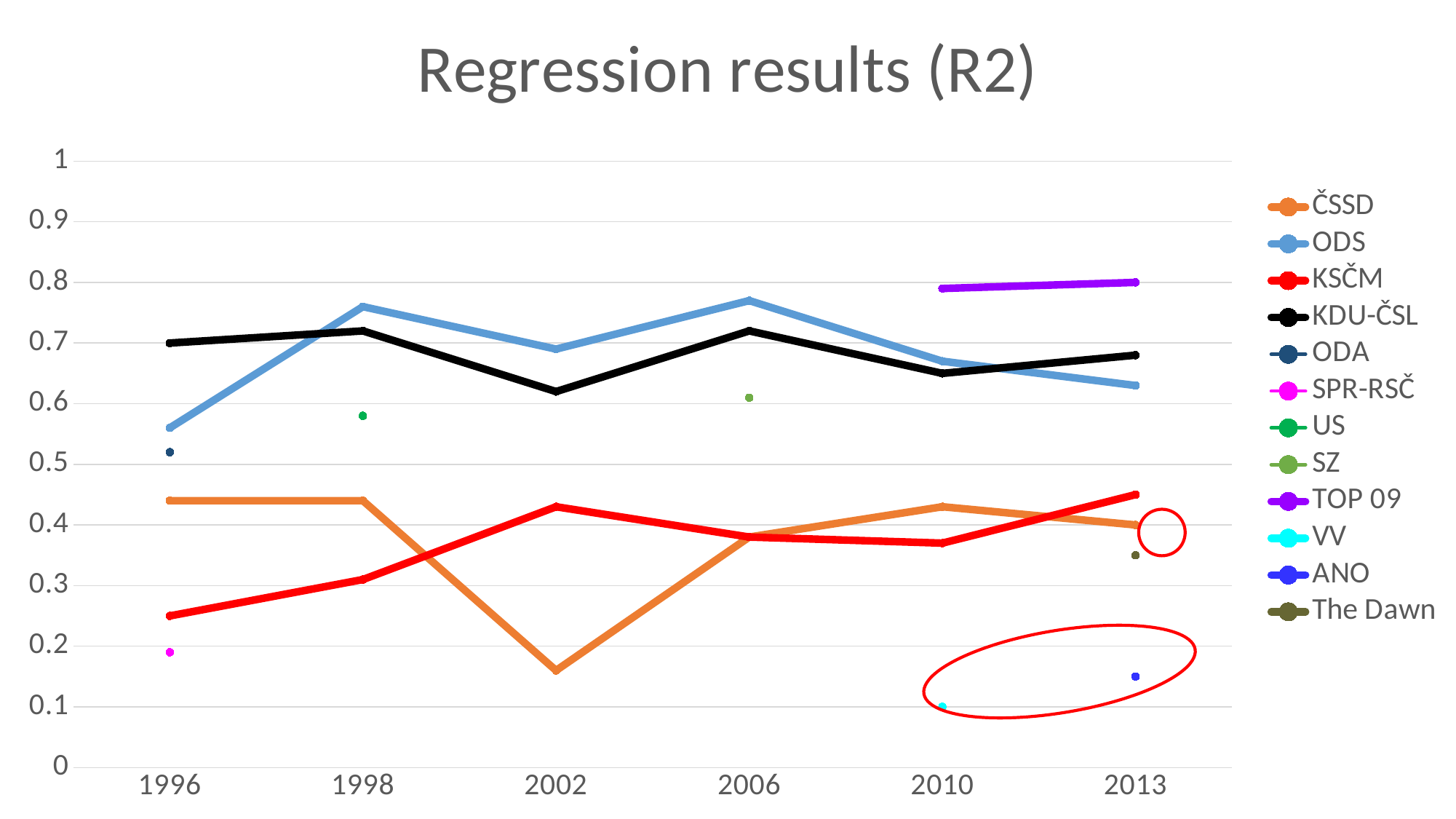
What kind of chart is shown on the slide? line chart Is the value for TOP 09 in 2010 greater or less than 0.7? greater Which series has the highest value in 2013? TOP 09 What is the title of the chart? Regression results (R2) How many years are shown on the x axis? 6 Is the value for ODS in 1998 greater or less than 0.7? greater Is the value for KDU-ČSL in 2002 greater or less than 0.7? less In 1996, which series has the higher value, ODS or KDU-ČSL? KDU-ČSL Which series has the lowest value anywhere on the chart? VV How many series does the legend list? 12 In 2013, which series has the higher value, KSČM or ČSSD? KSČM